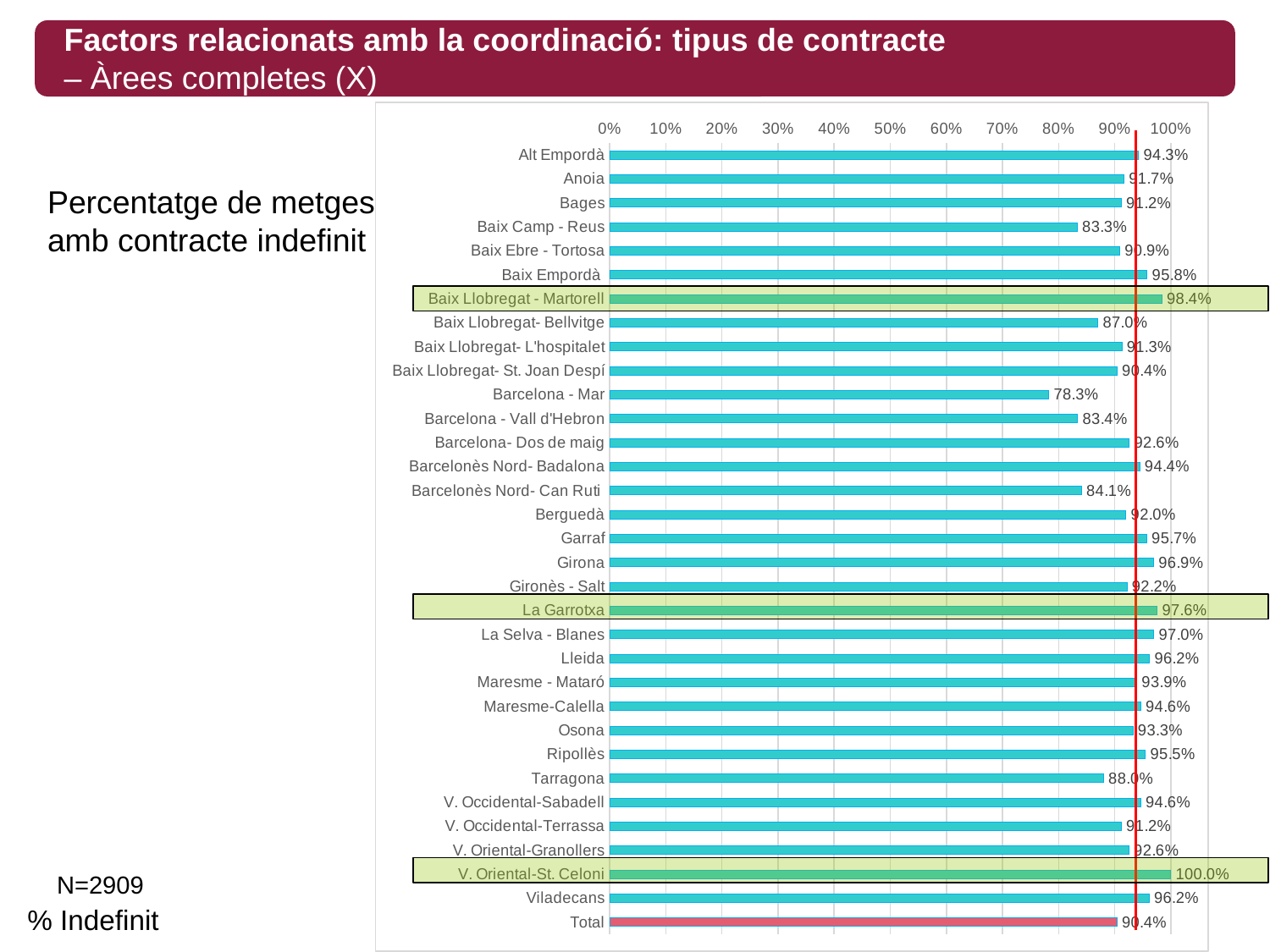
What is the value for Barcelona - Mar? 78.3% Which category has the highest value? V. Oriental-St. Celoni What colour is the Total bar? Red Which is larger, the value for Lleida or the value for Osona? Lleida What is the difference between the value for Baix Llobregat - Martorell and the Total value? 8.0 percentage points What kind of chart is shown on the slide? Bar chart What is the value for Baix Llobregat - Martorell? 98.4% How many bars are plotted in the chart, including Total? 33 What is the value for the Total bar? 90.4% What is the difference between the value for Girona and the value for Tarragona? 8.9 percentage points Which category has the lowest value? Barcelona - Mar What is the value for Tarragona? 88.0%